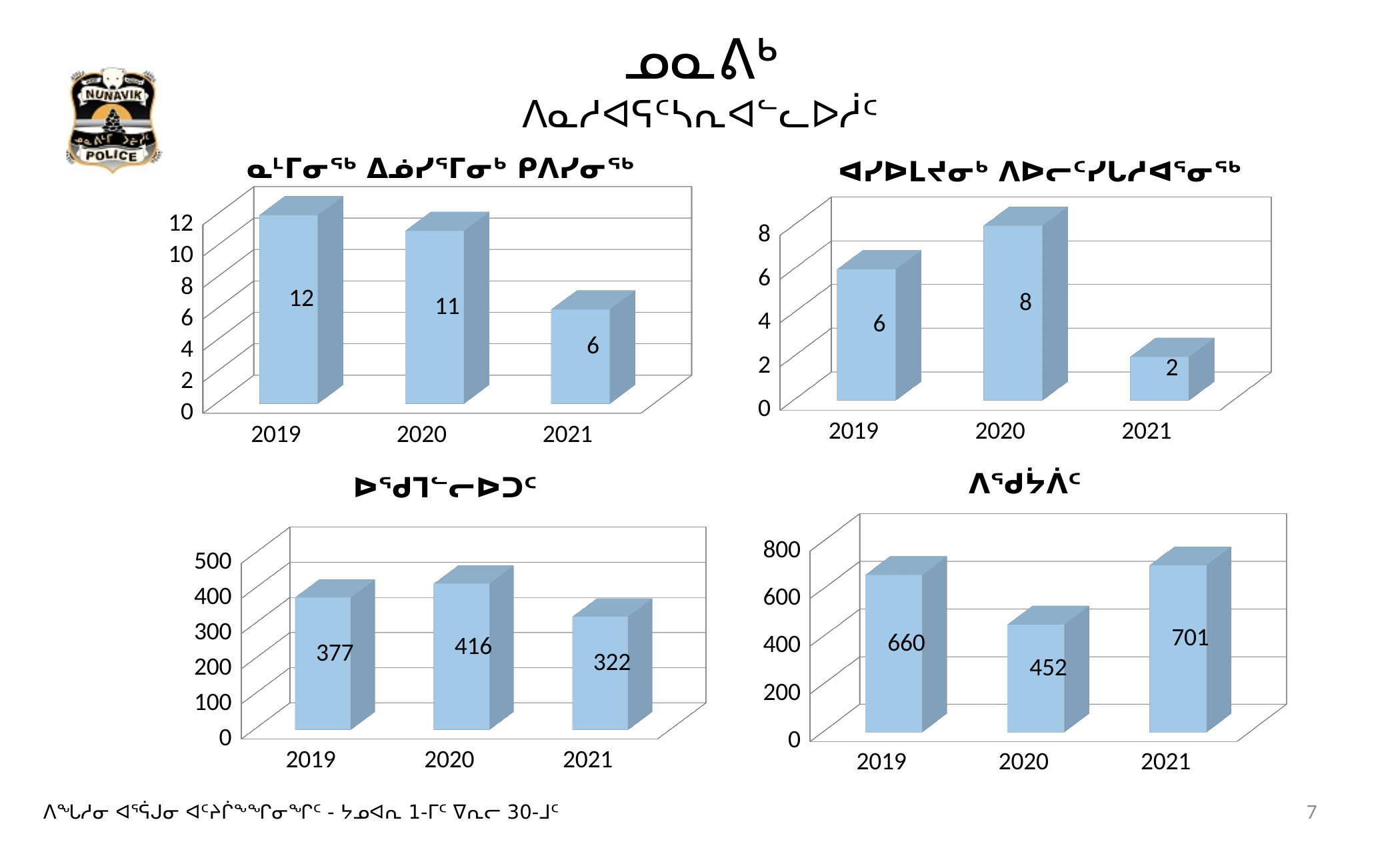
What kind of chart is the bottom-left chart? bar chart In the top-right chart, which year has the highest value? 2020 In the top-left chart, what is the value for 2019? 12 How many years are shown on the x axis of the bottom-right chart? 3 In the top-right chart, is the value for 2021 greater or less than 4? less In the top-left chart, which year has the lowest value? 2021 In the top-left chart, what is the difference between the values for 2019 and 2021? 6 In the top-right chart, what is the value for 2020? 8 In the bottom-right chart, what is the difference between the values for 2021 and 2020? 249 In the bottom-left chart, what is the value for 2020? 416 In the bottom-right chart, what is the value for 2021? 701 In the bottom-left chart, which is larger, the value for 2019 or the value for 2021? 2019